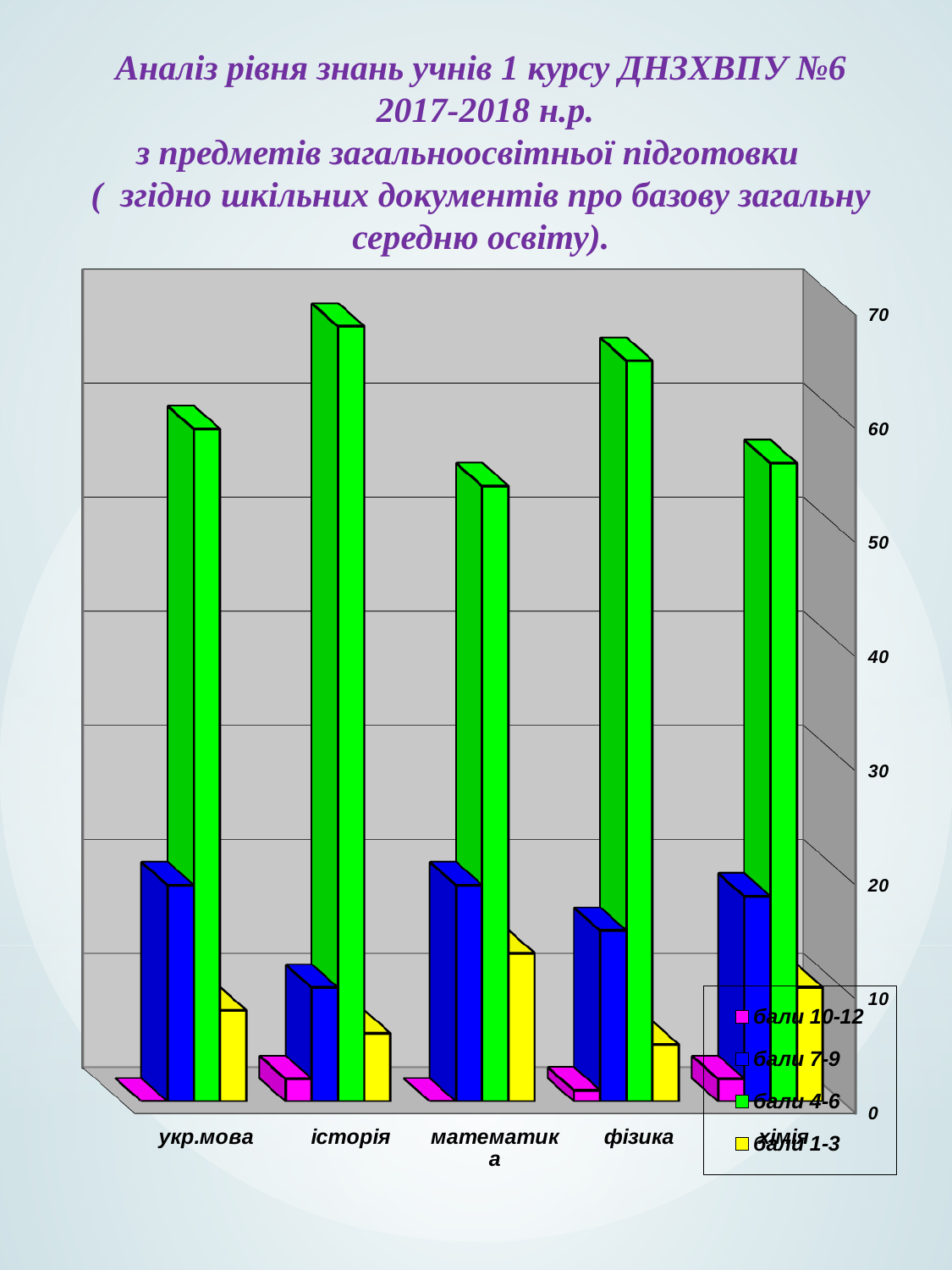
Which subject has the lowest value for бали 7-9? історія Which is larger for бали 4-6: укр.мова or історія? історія What is the highest value shown on the vertical axis? 70 What kind of chart is shown on the slide? bar chart Is the value of бали 7-9 for історія greater or less than 20? less Is the value of бали 4-6 for історія greater or less than 60? greater Which colour represents the series бали 4-6 in the legend? green Which is larger for бали 7-9: укр.мова or історія? укр.мова How many subject categories are shown on the x axis? 5 How many series does the legend list? 4 Which subject has the highest value for бали 4-6? історія Is the value of бали 4-6 for математика greater or less than 60? less